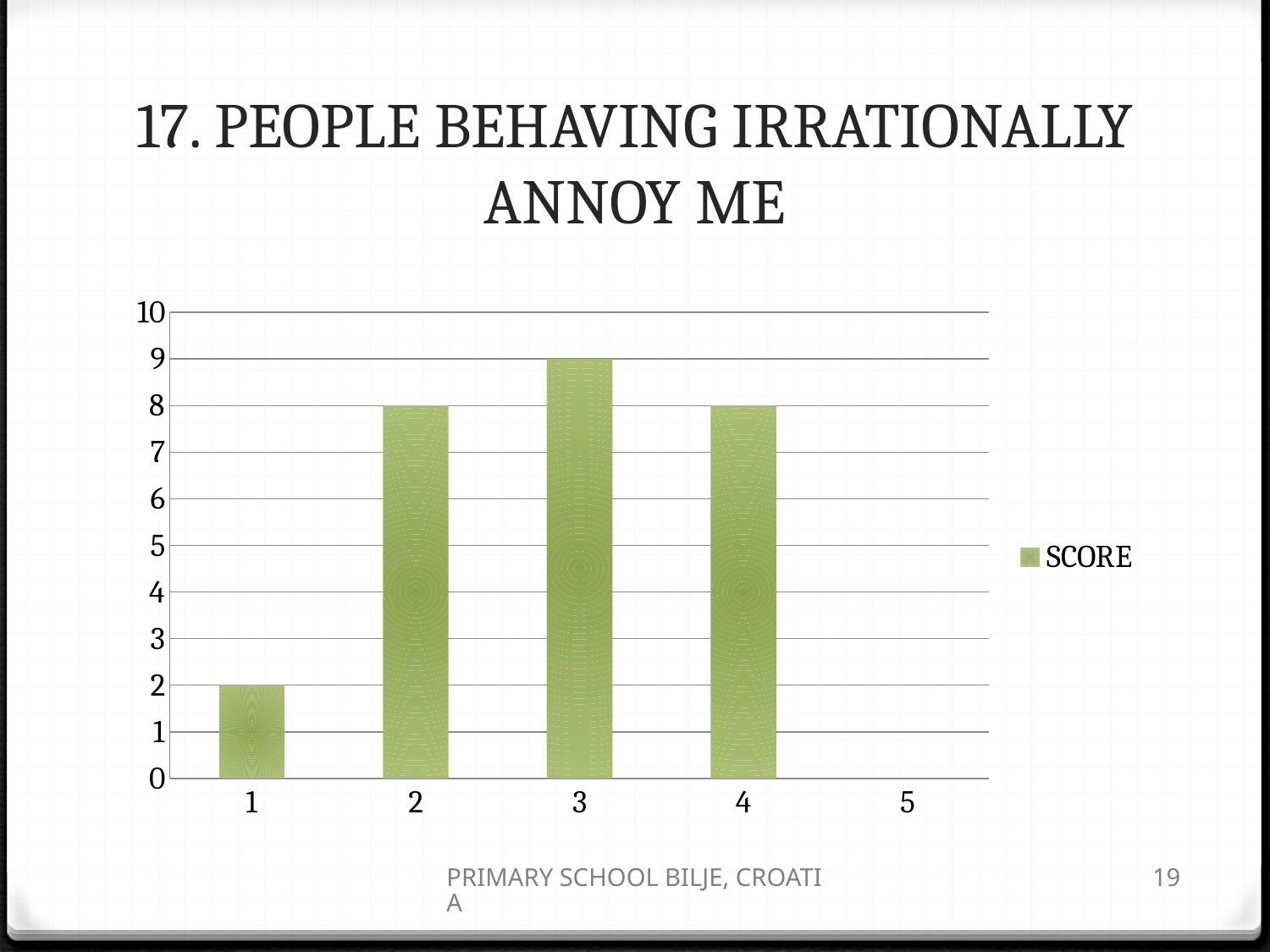
What is the difference between the SCORE for category 3 and the SCORE for category 1? 7 Which has a larger SCORE, category 2 or category 1? 2 What is the SCORE value for category 1? 2 How many series does the legend list? 1 How many categories are shown on the x axis? 5 Which category has the highest SCORE? 3 What is the SCORE value for category 3? 9 Is the SCORE for category 4 greater or less than 5? greater What kind of chart is shown on the slide? bar chart Which category with a visible bar has the lowest SCORE? 1 What is the SCORE value for category 2? 8 What is the name of the series shown in the legend? SCORE